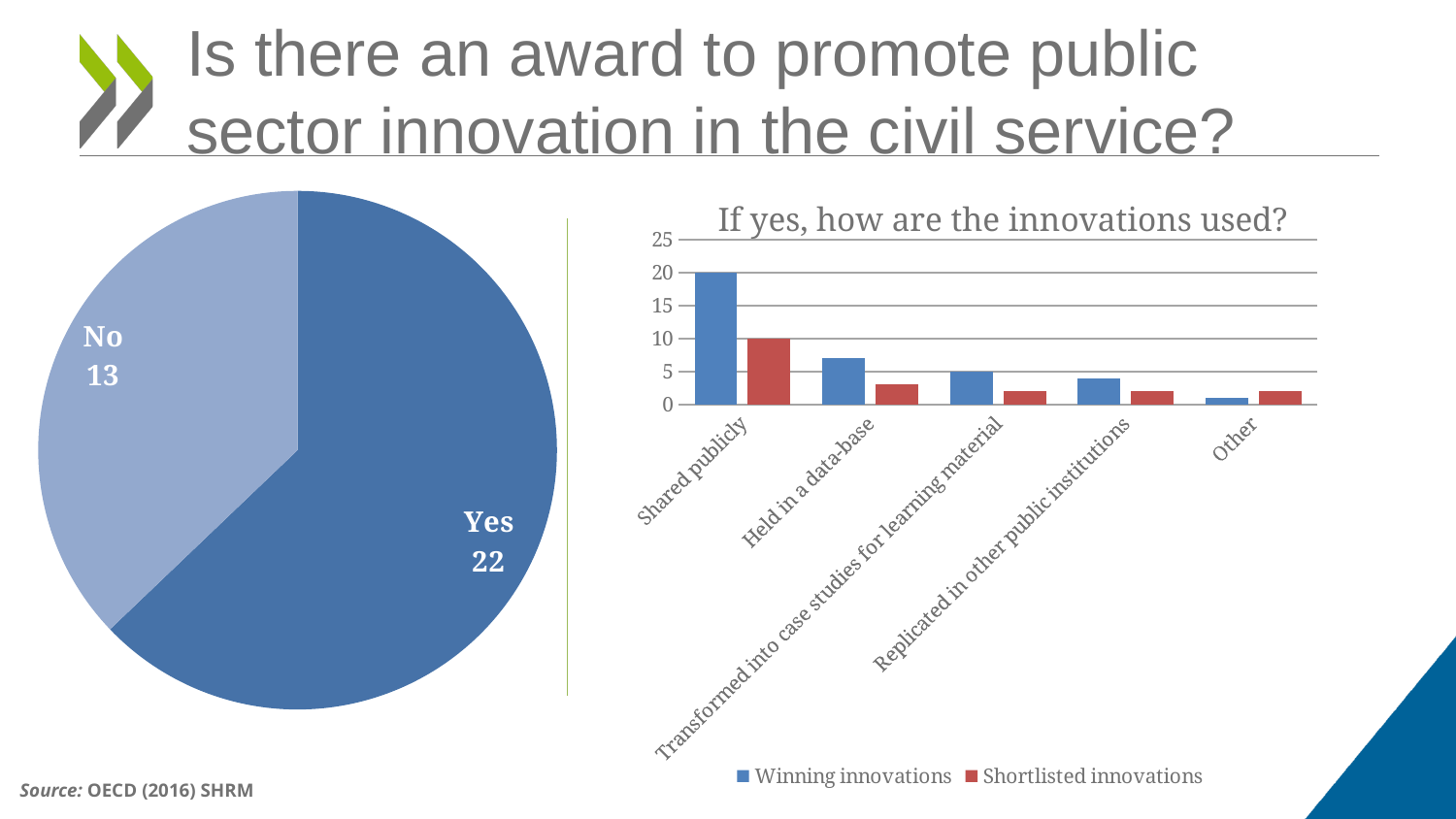
On the pie chart on the left, what is the difference between the Yes and No counts? 9 What type of chart is the chart on the left of the slide? Pie chart On the pie chart on the left, how many respondents answered Yes? 22 In the chart 'If yes, how are the innovations used?', what is the value for Winning innovations in the 'Shared publicly' category? 20 In the chart 'If yes, how are the innovations used?', is the value for Winning innovations in 'Held in a data-base' greater or less than 5? greater In the chart 'If yes, how are the innovations used?', what is the value for Shortlisted innovations in the 'Shared publicly' category? 10 In the chart 'If yes, how are the innovations used?', which category has the highest value for Winning innovations? Shared publicly In the chart 'If yes, how are the innovations used?', how many categories are shown on the x axis? 5 In the chart 'If yes, how are the innovations used?', how many series does the legend list? 2 On the pie chart on the left, which answer has the larger slice, Yes or No? Yes On the pie chart on the left, how many slices are there? 2 On the pie chart on the left, how many respondents answered No? 13